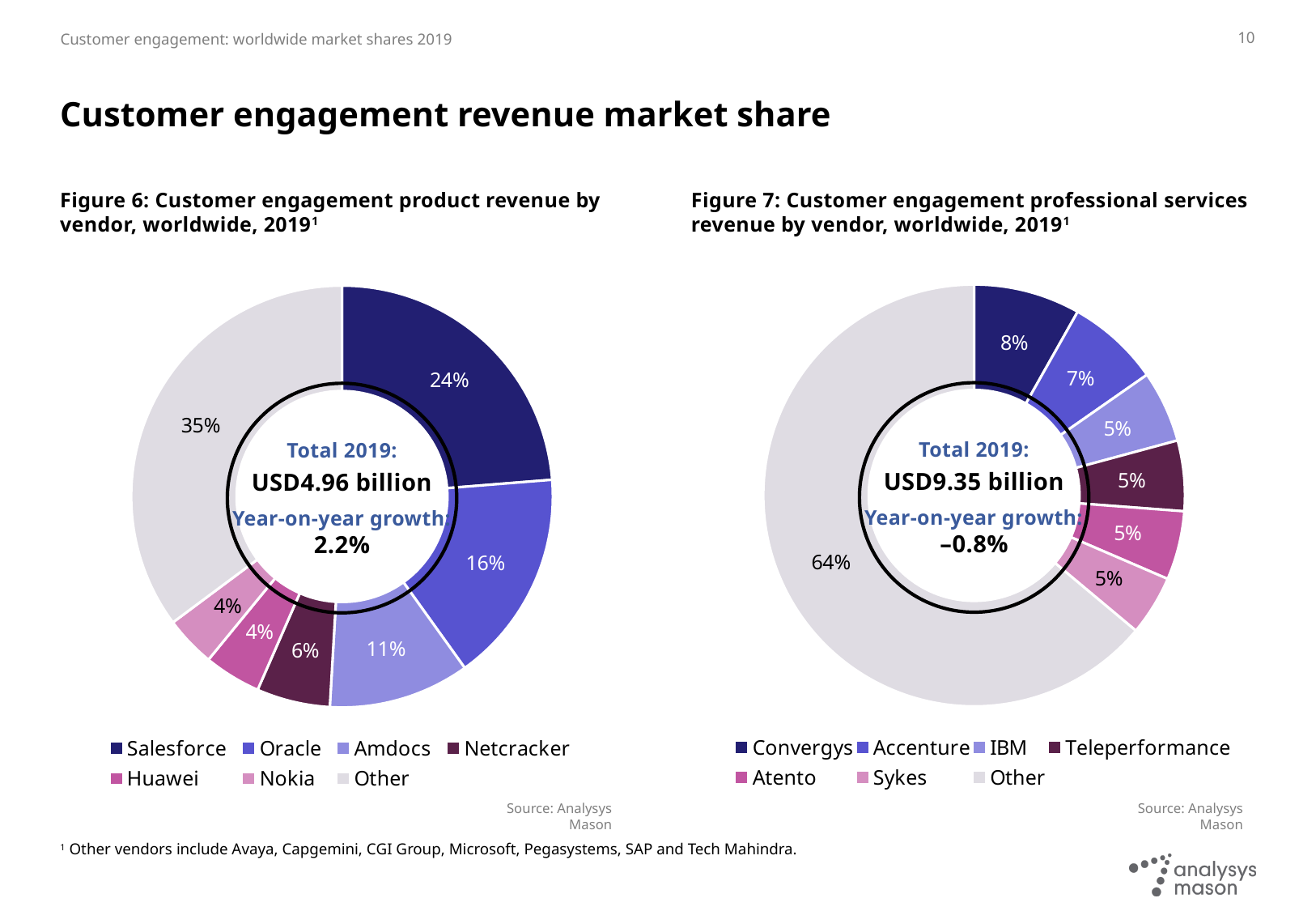
In Figure 7, what share is attributed to Other vendors? 64% In Figure 7, what is Accenture's share of professional services revenue? 7% In Figure 6, which named vendor (excluding Other) has the largest share? Salesforce In Figure 6, which has the larger share, Netcracker or Huawei? Netcracker In Figure 6, what is Amdocs's share of product revenue? 11% In Figure 6, what share of customer engagement product revenue does Salesforce hold? 24% In Figure 7, what is the year-on-year growth shown in the centre of the chart? –0.8% In Figure 6, how many vendor categories does the legend list? 7 In Figure 6, what is the difference in share between Salesforce and Oracle? 8 percentage points In Figure 7, what share of professional services revenue does Convergys hold? 8% What type of chart is used in Figure 7? Pie (donut) chart In Figure 6, what is the total 2019 customer engagement product revenue shown in the centre of the chart? USD4.96 billion